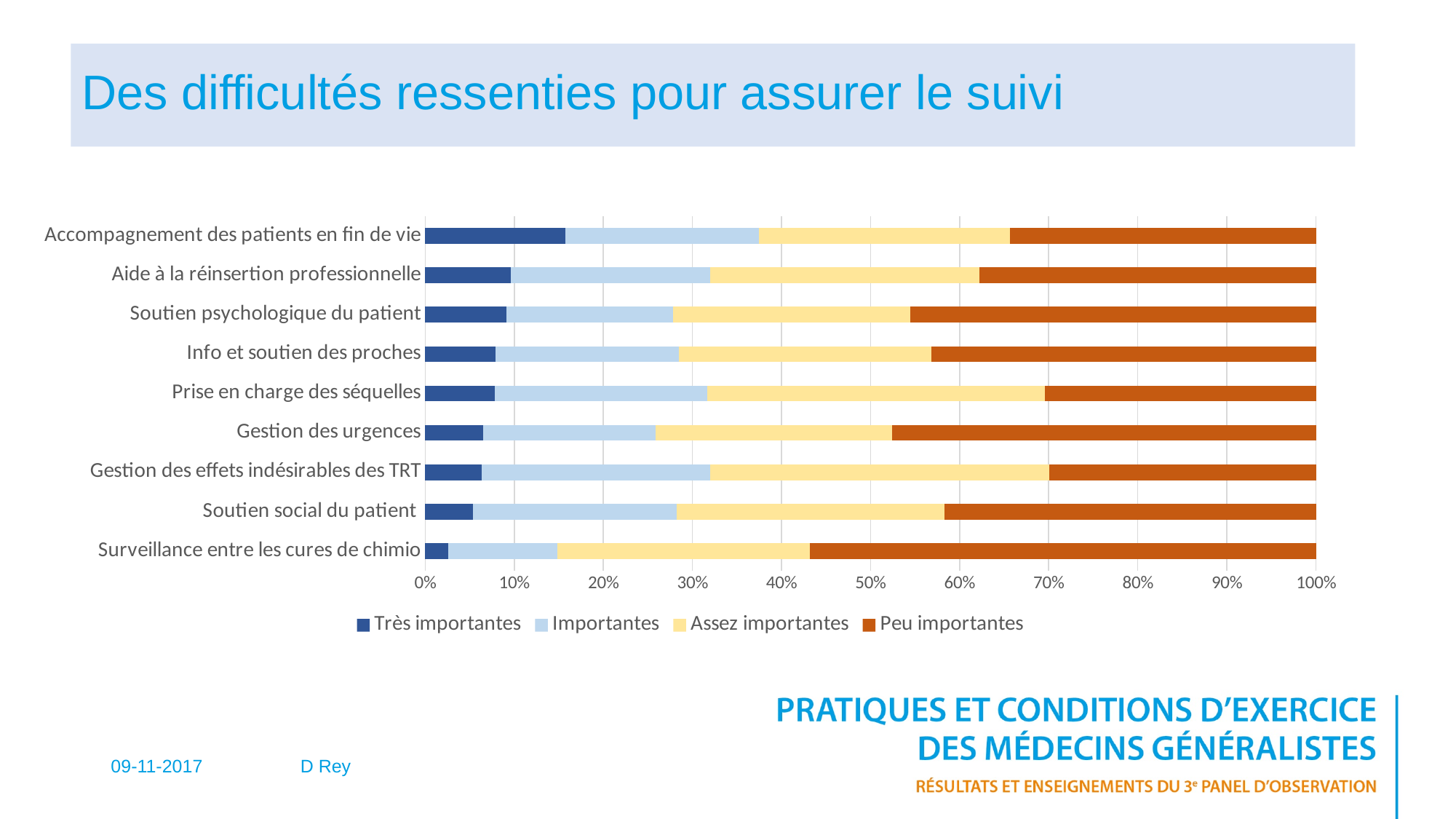
Is the 'Peu importantes' value for 'Surveillance entre les cures de chimio' greater or less than 50%? greater Which category has the smallest 'Très importantes' segment? Surveillance entre les cures de chimio What is the title of the slide containing the chart? Des difficultés ressenties pour assurer le suivi What kind of chart is shown on the slide? bar chart Which has the larger 'Très importantes' segment: 'Aide à la réinsertion professionnelle' or 'Surveillance entre les cures de chimio'? Aide à la réinsertion professionnelle Is the 'Très importantes' value for 'Soutien social du patient' greater or less than 10%? less Which category has the largest 'Très importantes' segment? Accompagnement des patients en fin de vie How many categories (difficulties) are listed on the vertical axis of the chart? 9 What is the total of the stacked bar for 'Gestion des urgences'? 100% Which category has the largest 'Peu importantes' segment? Surveillance entre les cures de chimio How many series does the chart legend list? 4 Is the 'Très importantes' value for 'Accompagnement des patients en fin de vie' greater or less than 10%? greater